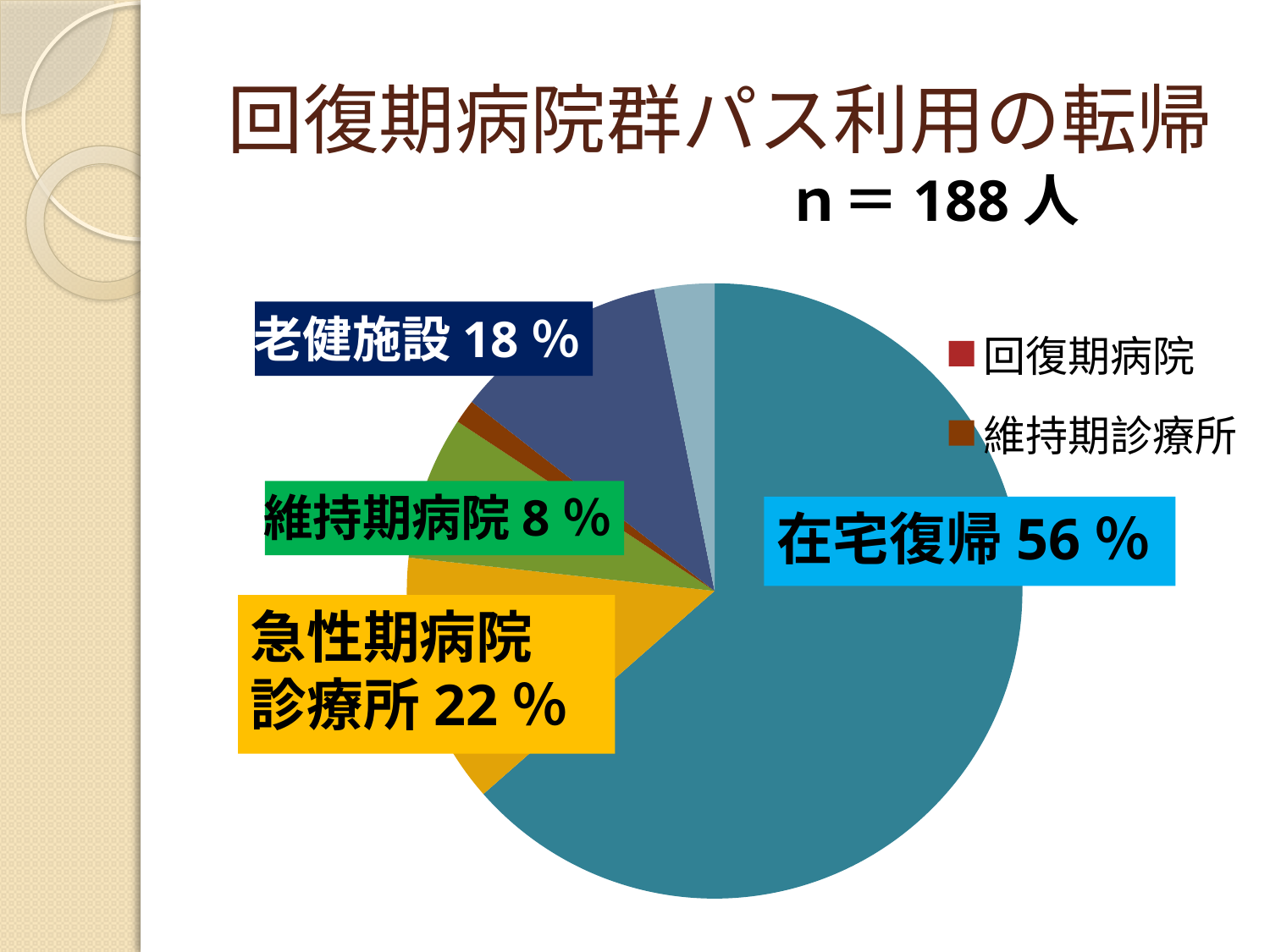
What percentage is shown for 維持期病院 in the pie chart? 8 % Among the categories with a printed percentage label, which has the smallest share? 維持期病院 What percentage is shown for 老健施設 in the pie chart? 18 % What sample size (n) is stated on the slide? n = 188 人 What is the difference in percentage points between 急性期病院診療所 and 維持期病院? 14 % What kind of chart is shown on the slide? Pie chart What percentage is shown for 急性期病院診療所 in the pie chart? 22 % What is the title of the slide's chart? 回復期病院群パス利用の転帰 How many percentage points larger is the 在宅復帰 share than the 老健施設 share? 38 % What percentage does the 在宅復帰 slice represent in the pie chart? 56 % Which slice is larger, 急性期病院診療所 or 老健施設? 急性期病院診療所 Which category has the largest slice in the pie chart? 在宅復帰